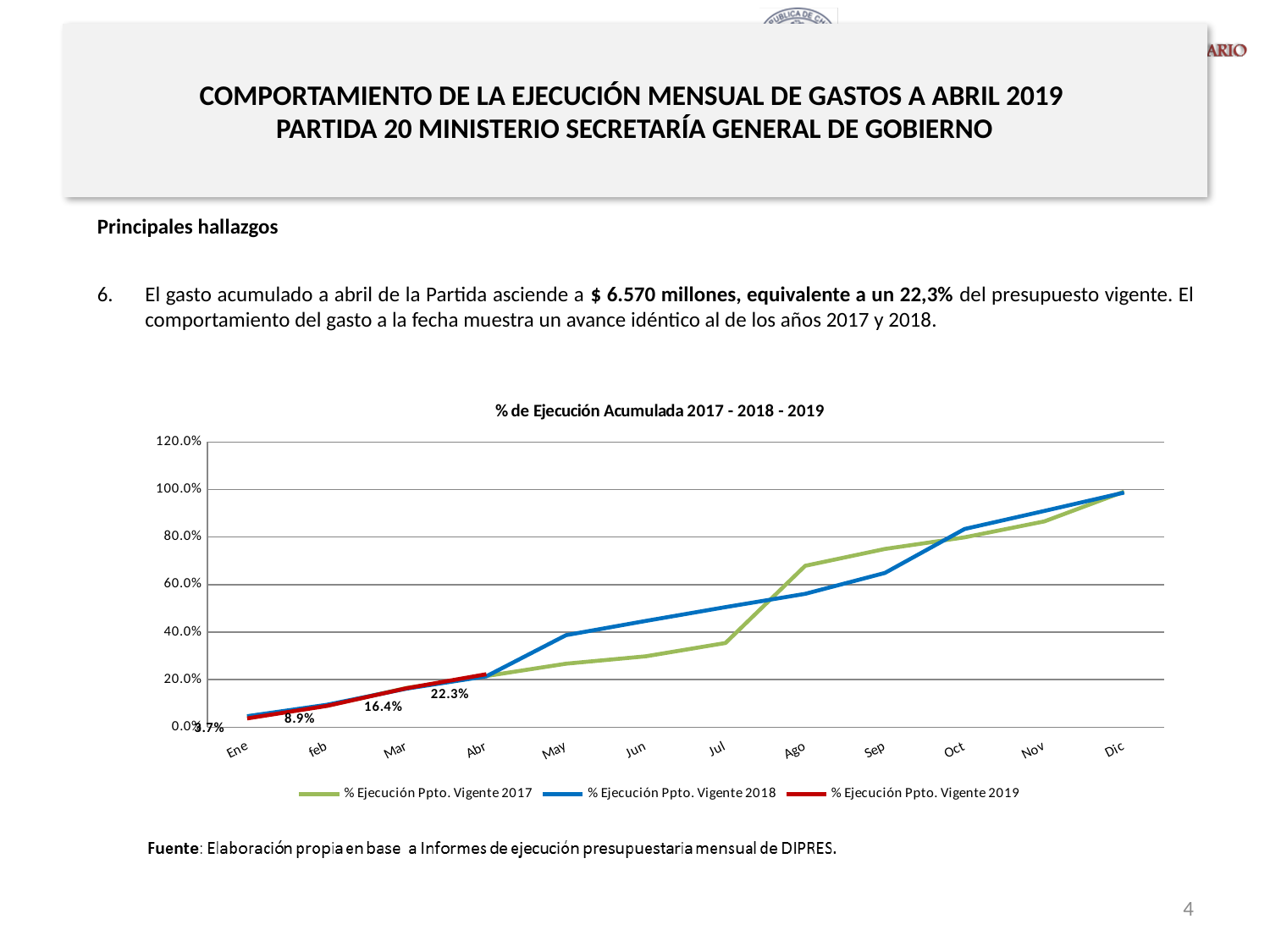
What is the value for Ene in the % Ejecución Ppto. Vigente 2019 series? 3.7% What is the value for Abr in the % Ejecución Ppto. Vigente 2019 series? 22.3% Is the value for May in the % Ejecución Ppto. Vigente 2018 series greater or less than 20%? greater What is the difference between the Abr and Mar values of the % Ejecución Ppto. Vigente 2019 series? 5.9% Which series has the higher value in Ago, % Ejecución Ppto. Vigente 2017 or % Ejecución Ppto. Vigente 2018? % Ejecución Ppto. Vigente 2017 What is the title of the chart? % de Ejecución Acumulada 2017 - 2018 - 2019 What kind of chart is shown on the slide? Line chart What is the value for Mar in the % Ejecución Ppto. Vigente 2019 series? 16.4% How many series does the legend list? 3 What is the value for Feb in the % Ejecución Ppto. Vigente 2019 series? 8.9% How many months are shown on the x axis? 12 Do the values of the % Ejecución Ppto. Vigente 2018 series rise or fall from Ene to Dic? Rise